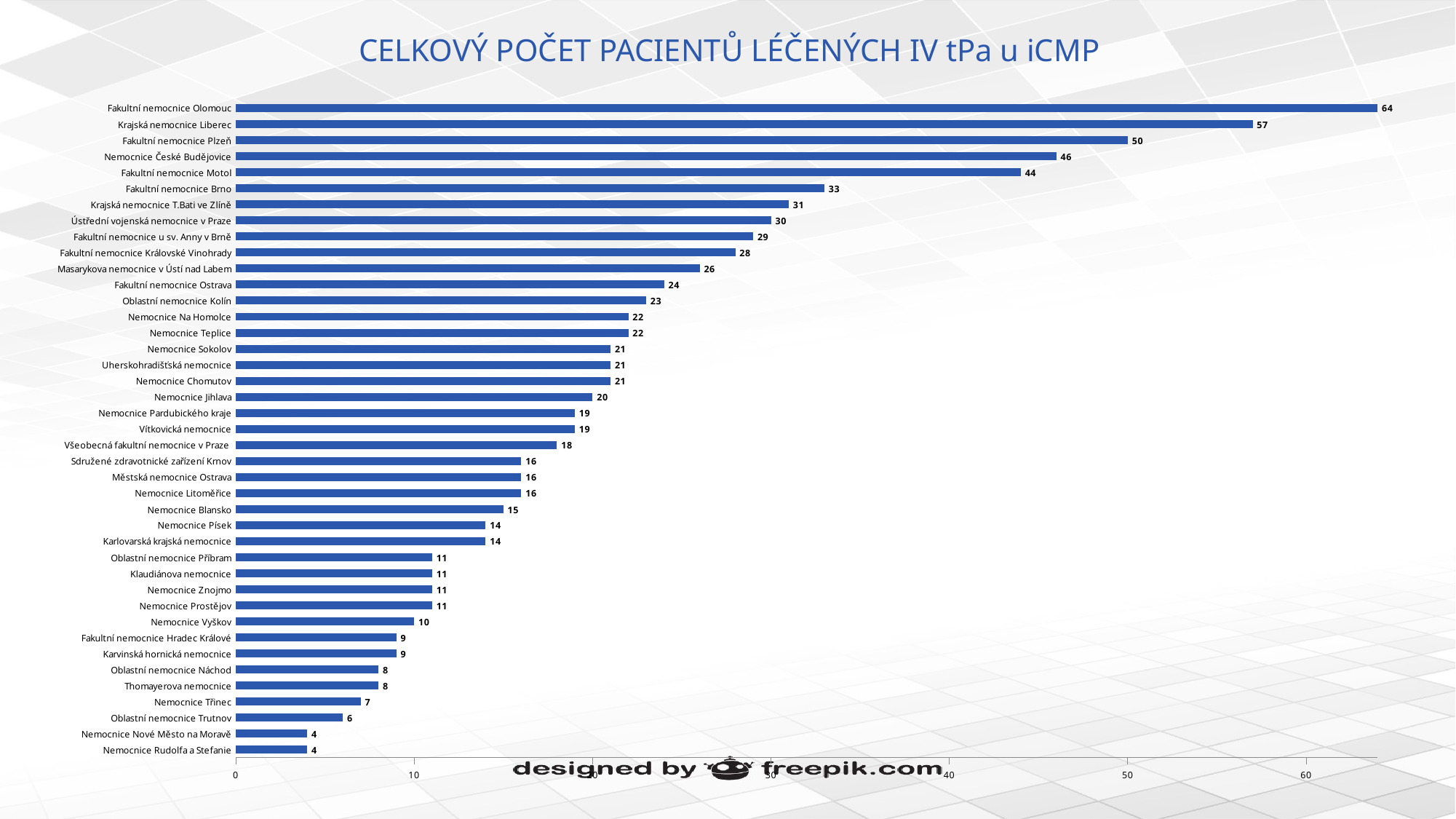
Which hospital has the highest value? Fakultní nemocnice Olomouc What is the difference between the values for Fakultní nemocnice Olomouc and Nemocnice Rudolfa a Stefanie? 60 Which is larger, the value for Fakultní nemocnice Motol or the value for Nemocnice České Budějovice? Nemocnice České Budějovice How many hospitals are shown in the chart? 41 What is the title of the chart? CELKOVÝ POČET PACIENTŮ LÉČENÝCH IV tPa u iCMP What is the value for Nemocnice Na Homolce? 22 What is the value for Fakultní nemocnice Brno? 33 What is the value for Fakultní nemocnice Olomouc? 64 What is the value for Oblastní nemocnice Trutnov? 6 What kind of chart is shown on the slide? bar chart What is the difference between the values for Krajská nemocnice Liberec and Fakultní nemocnice Plzeň? 7 Is the value for Fakultní nemocnice Ostrava greater or less than 20? greater